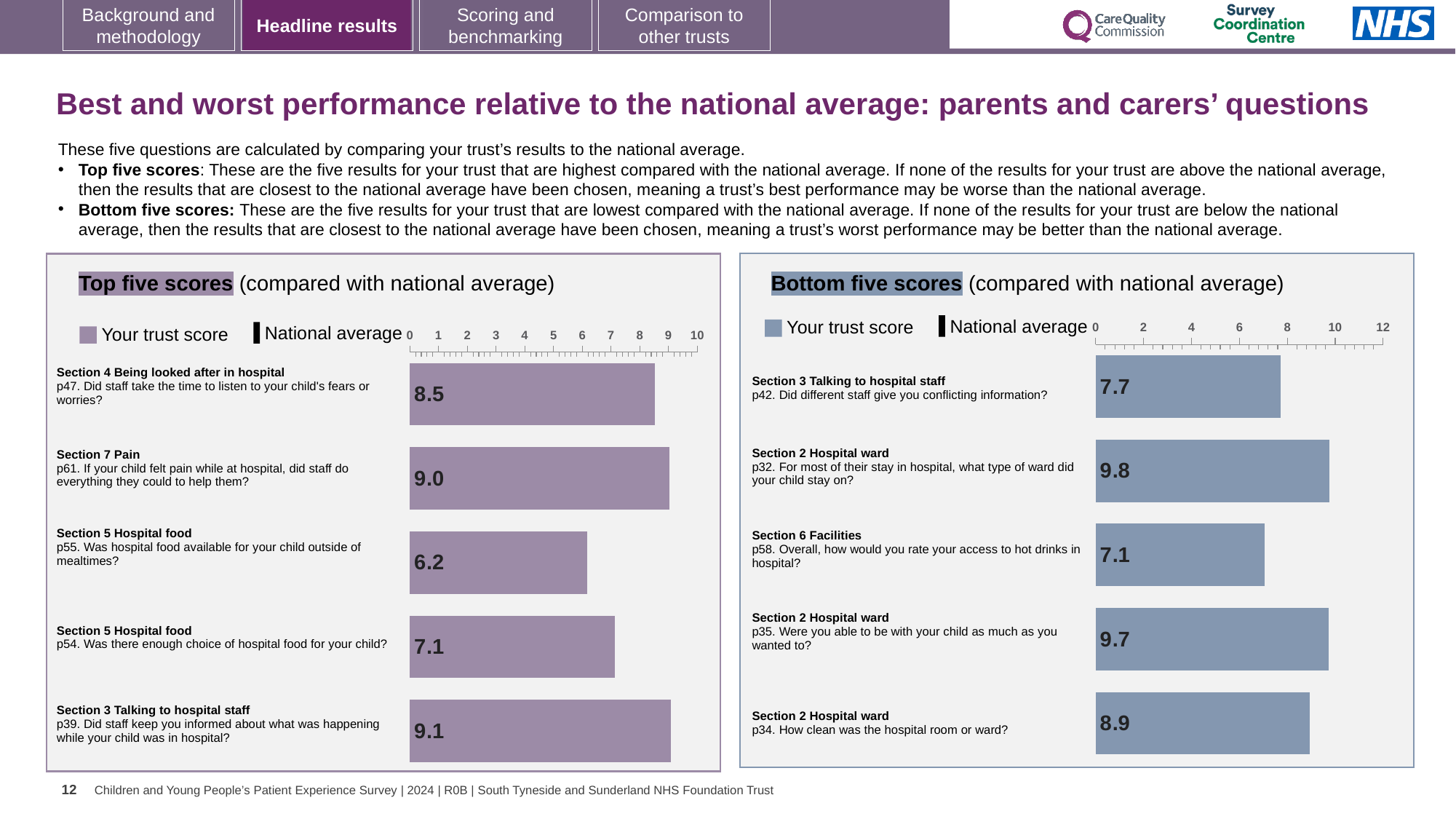
In the Bottom five scores chart, what is the trust score for p42 (Did different staff give you conflicting information?)? 7.7 How many questions are plotted in the Bottom five scores chart? 5 In the Bottom five scores chart, which has the larger trust score: p32 or p35? p32 In the Top five scores chart, what is the trust score for p61 (If your child felt pain while at hospital, did staff do everything they could to help them?)? 9.0 In the Top five scores chart, what is the trust score for p55 (Was hospital food available for your child outside of mealtimes?)? 6.2 In the Top five scores chart, what is the difference between the trust scores for p39 and p55? 2.9 In the Bottom five scores chart, what is the trust score for p34 (How clean was the hospital room or ward?)? 8.9 In the Top five scores chart, which question has the highest trust score? p39. Did staff keep you informed about what was happening while your child was in hospital? In the Bottom five scores chart, which question has the lowest trust score? p58. Overall, how would you rate your access to hot drinks in hospital? What type of chart is the Top five scores chart? Bar chart How many series does the legend of the Top five scores chart list? 2 In the Bottom five scores chart, what is the maximum value shown on the axis? 12